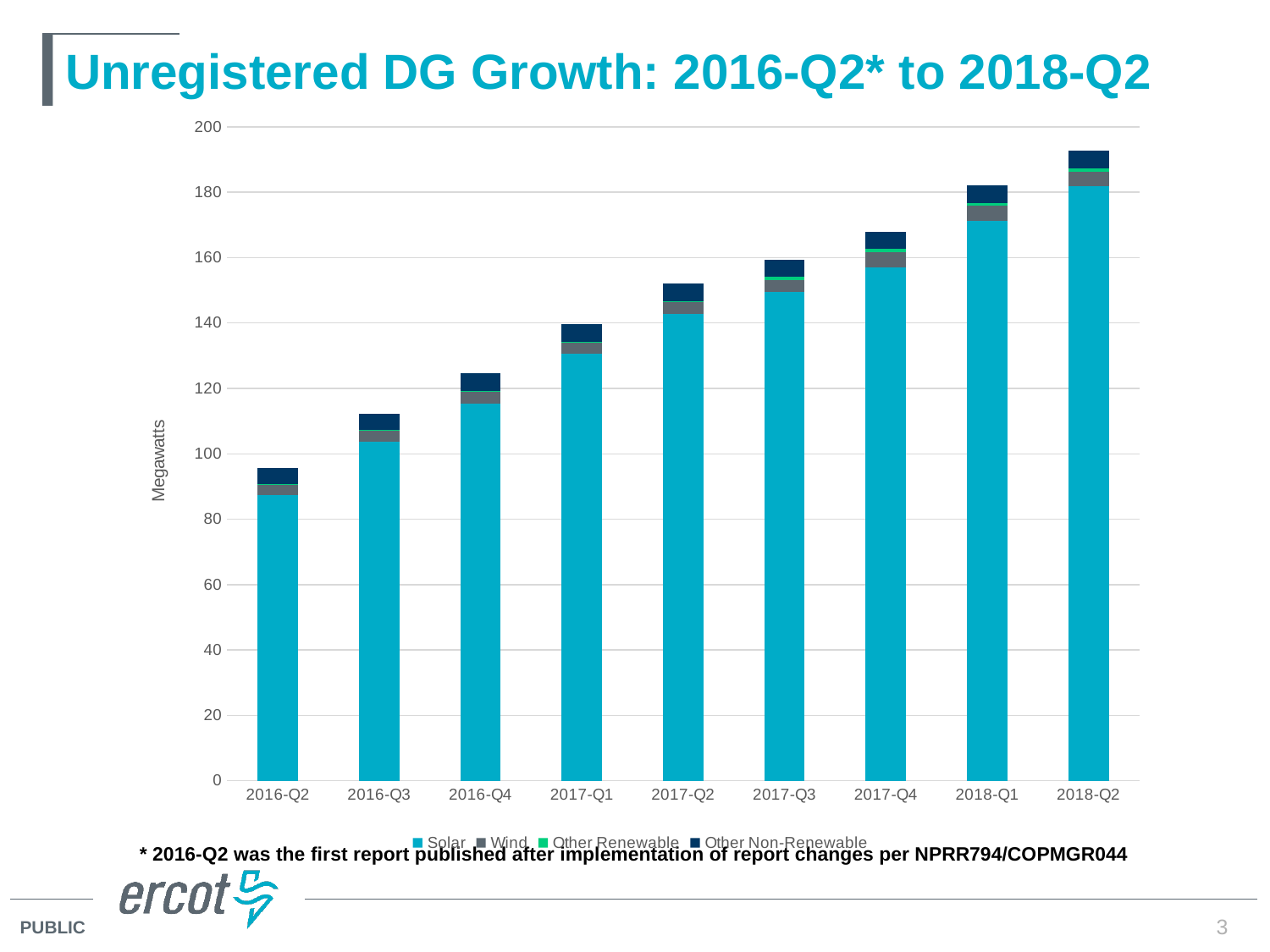
Which quarter has the highest total bar? 2018-Q2 Do the total bar heights rise or fall from 2016-Q2 to 2018-Q2? Rise How many series does the legend list? 4 How many quarters (categories) are plotted along the x axis? 9 What is the label on the vertical axis? Megawatts Which series makes up the largest portion of every bar? Solar Which quarter has the lowest total bar? 2016-Q2 Is the total bar for 2017-Q4 greater or less than 160 megawatts? greater What kind of chart is shown on the slide? Stacked bar chart Is the total bar for 2018-Q2 greater or less than 180 megawatts? greater Is the total bar for 2016-Q2 greater or less than 100 megawatts? less Which total bar is taller, 2017-Q2 or 2016-Q3? 2017-Q2